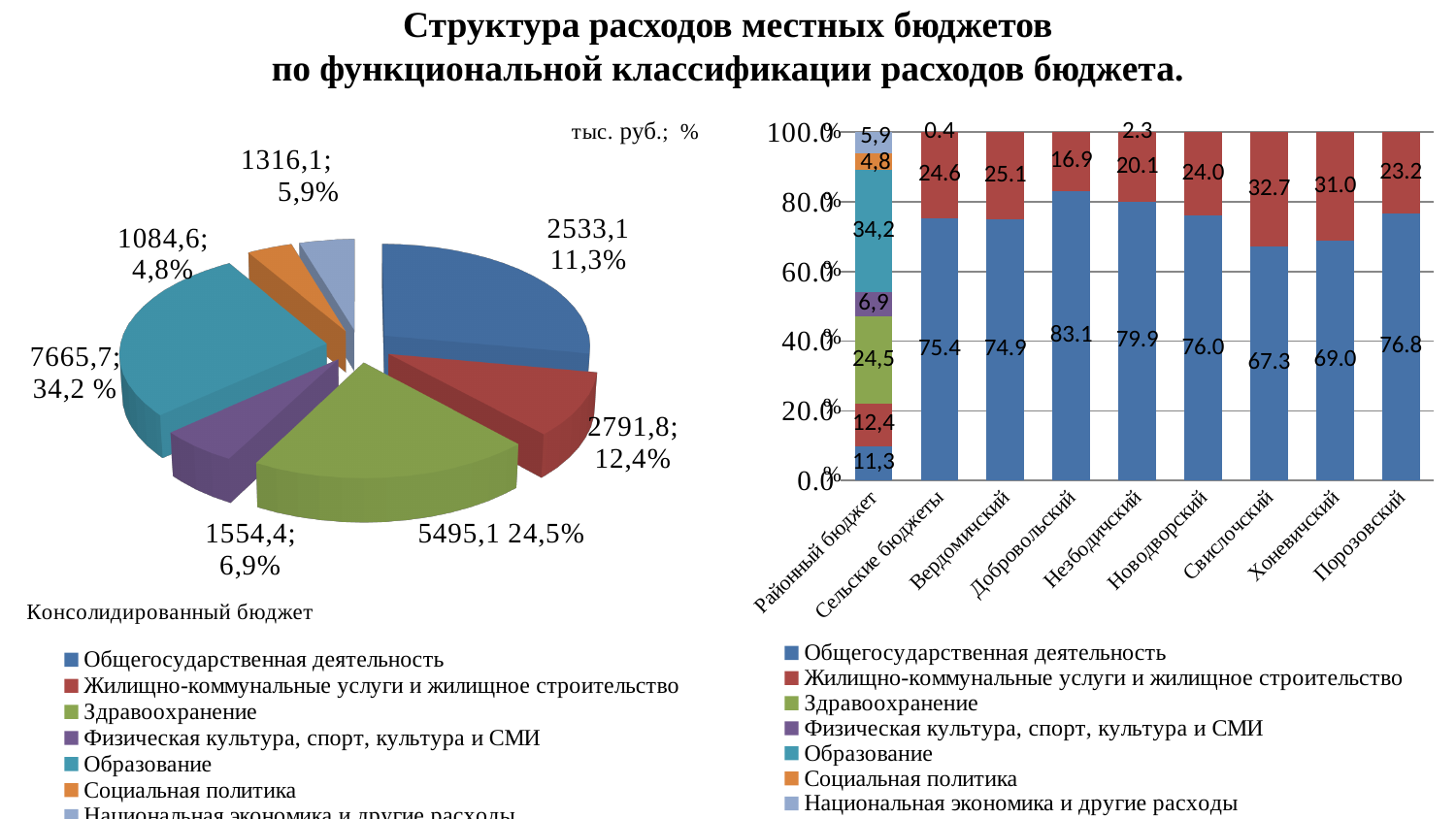
In the pie chart (Консолидированный бюджет), what value is shown for Образование? 7665,7 In the stacked bar chart on the right, what is the value of Общегосударственная деятельность for Добровольский? 83.1 How many categories are shown on the x axis of the stacked bar chart on the right? 9 In the stacked bar chart on the right, which has the larger Общегосударственная деятельность value, Новодворский or Порозовский? Порозовский In the stacked bar chart on the right, what is the difference between the Общегосударственная деятельность values for Хоневичский and Свислочский? 1.7 In the pie chart (Консолидированный бюджет), which category has the smallest slice? Социальная политика In the stacked bar chart on the right, which category has the lowest value for Общегосударственная деятельность? Районный бюджет In the stacked bar chart on the right, which category has the highest value for Общегосударственная деятельность? Добровольский In the stacked bar chart on the right, what is the value of Жилищно-коммунальные услуги и жилищное строительство for Свислочский? 32.7 In the pie chart (Консолидированный бюджет), what share does Здравоохранение have? 24,5% In the pie chart (Консолидированный бюджет), which category has the largest slice? Образование In the pie chart (Консолидированный бюджет), what value is shown for Жилищно-коммунальные услуги и жилищное строительство? 2791,8